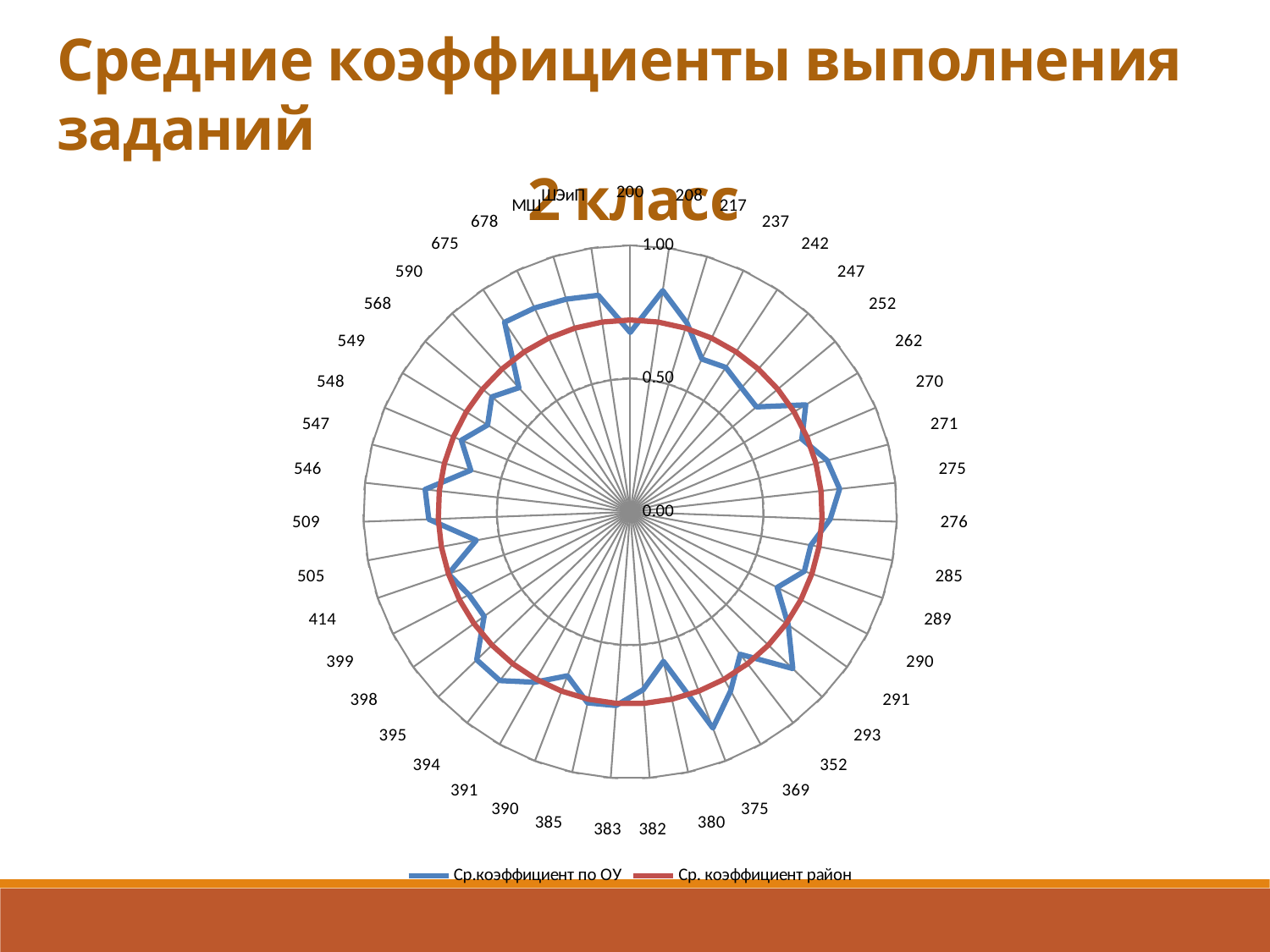
Is the value of 'Ср. коэффициент район' for 276 greater or less than 0.50? greater Is the value of 'Ср.коэффициент по ОУ' for 208 greater or less than 0.50? greater Is the value of 'Ср.коэффициент по ОУ' for 293 greater or less than 0.50? greater What kind of chart is shown on the slide? radar chart What are the two series named in the chart legend? Ср.коэффициент по ОУ and Ср. коэффициент район Which has the larger 'Ср.коэффициент по ОУ' value, 208 or 200? 208 How many series does the chart legend list? 2 Which colour represents the series 'Ср. коэффициент район'? red Which has the larger 'Ср.коэффициент по ОУ' value, 293 or 200? 293